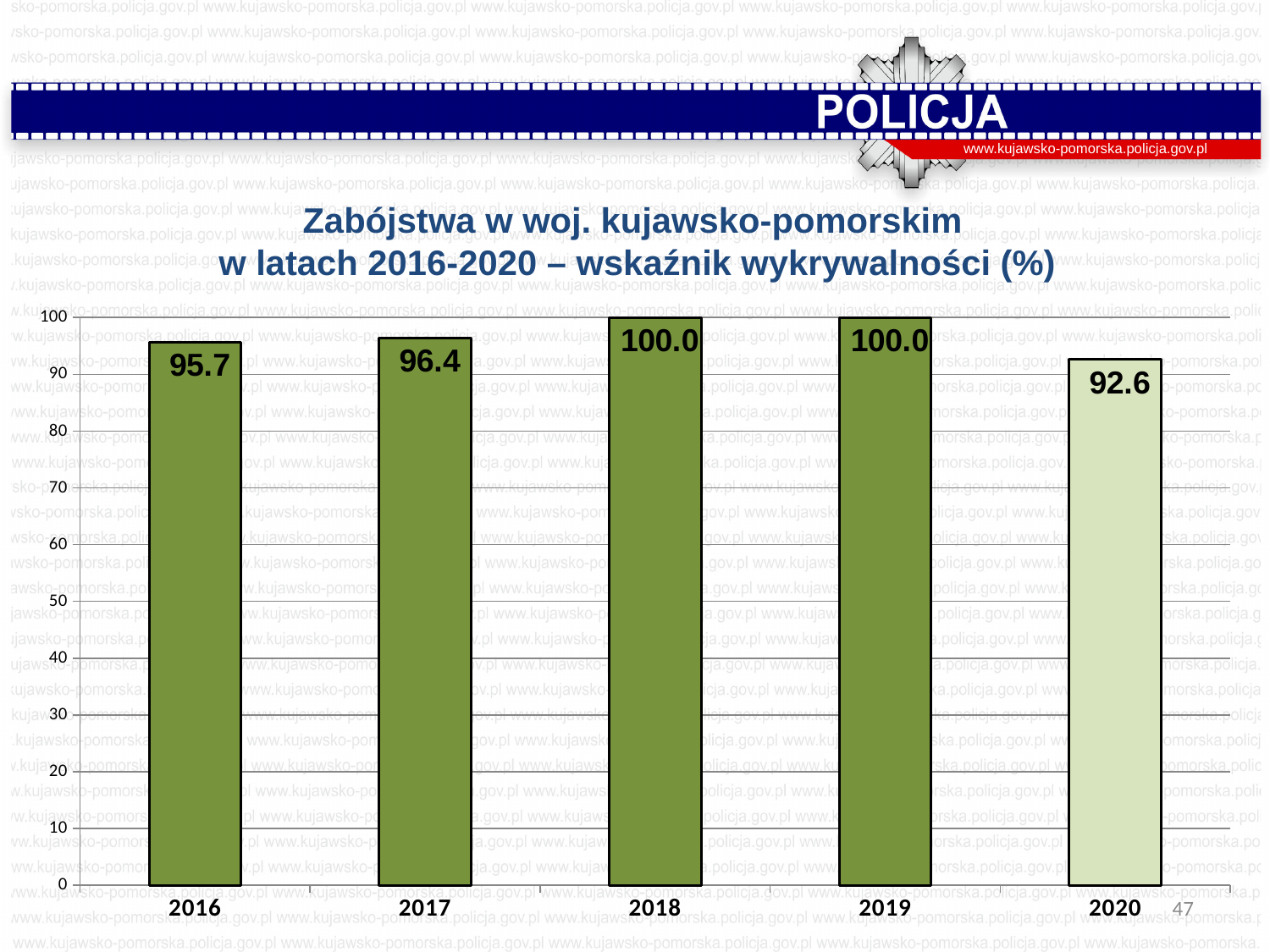
What value is shown for 2017? 96.4 What is the difference between the values for 2018 and 2020? 7.4 Which year has the lowest detection rate? 2020 What is the title of the chart? Zabójstwa w woj. kujawsko-pomorskim w latach 2016-2020 – wskaźnik wykrywalności (%) Which is larger, the value for 2016 or the value for 2020? 2016 What kind of chart is shown on the slide? bar chart Which years reached a detection rate of 100.0? 2018 and 2019 What is the difference between the values for 2017 and 2016? 0.7 What is the detection rate value shown for 2016? 95.7 Is the value for 2020 greater or less than 90? greater What is the detection rate value shown for 2020? 92.6 How many years are shown on the x axis? 5